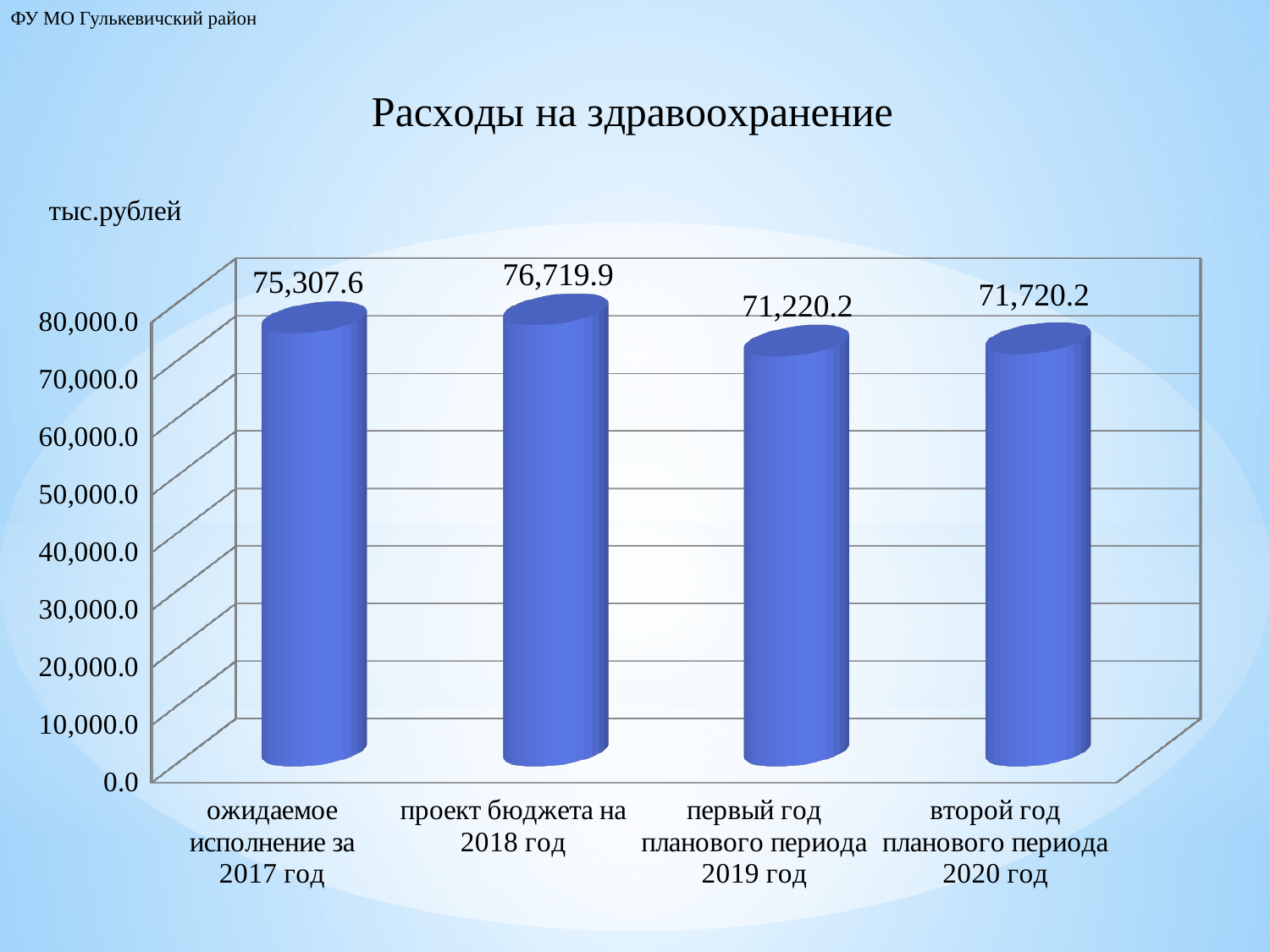
What is the difference between the values for 2018 and 2017? 1,412.3 What is the title of the chart? Расходы на здравоохранение What is the difference between the values for 2020 and 2019? 500.0 Which category has the lowest value? первый год планового периода 2019 год What is the value for 'ожидаемое исполнение за 2017 год'? 75,307.6 What is the value for 'проект бюджета на 2018 год'? 76,719.9 What is the value for 'второй год планового периода 2020 год'? 71,720.2 Which is larger: the value for 2017 or the value for 2018? 2018 What kind of chart is shown on the slide? bar chart Which category has the highest value? проект бюджета на 2018 год Is the value for 'первый год планового периода 2019 год' greater or less than 70,000.0? greater How many categories are shown on the chart? 4